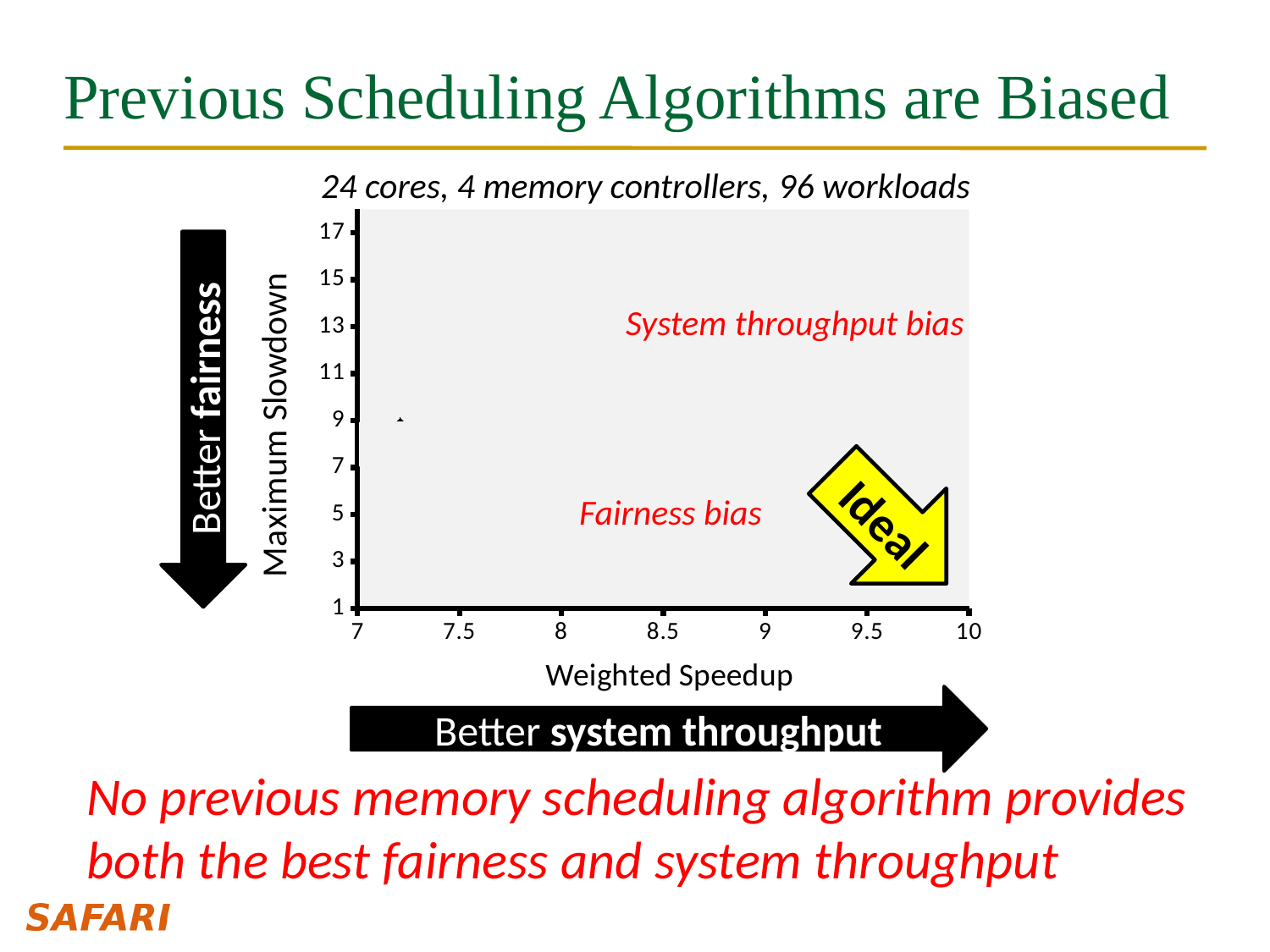
Is the Maximum Slowdown of the plotted point greater or less than 7? greater What kind of chart is shown on the slide? scatter chart Is the Weighted Speedup of the plotted point greater or less than 7.5? less How many data points are plotted on the chart? 1 Is the Maximum Slowdown of the plotted point greater or less than 11? less What is the label of the y axis of the chart? Maximum Slowdown What is the title of the chart? 24 cores, 4 memory controllers, 96 workloads